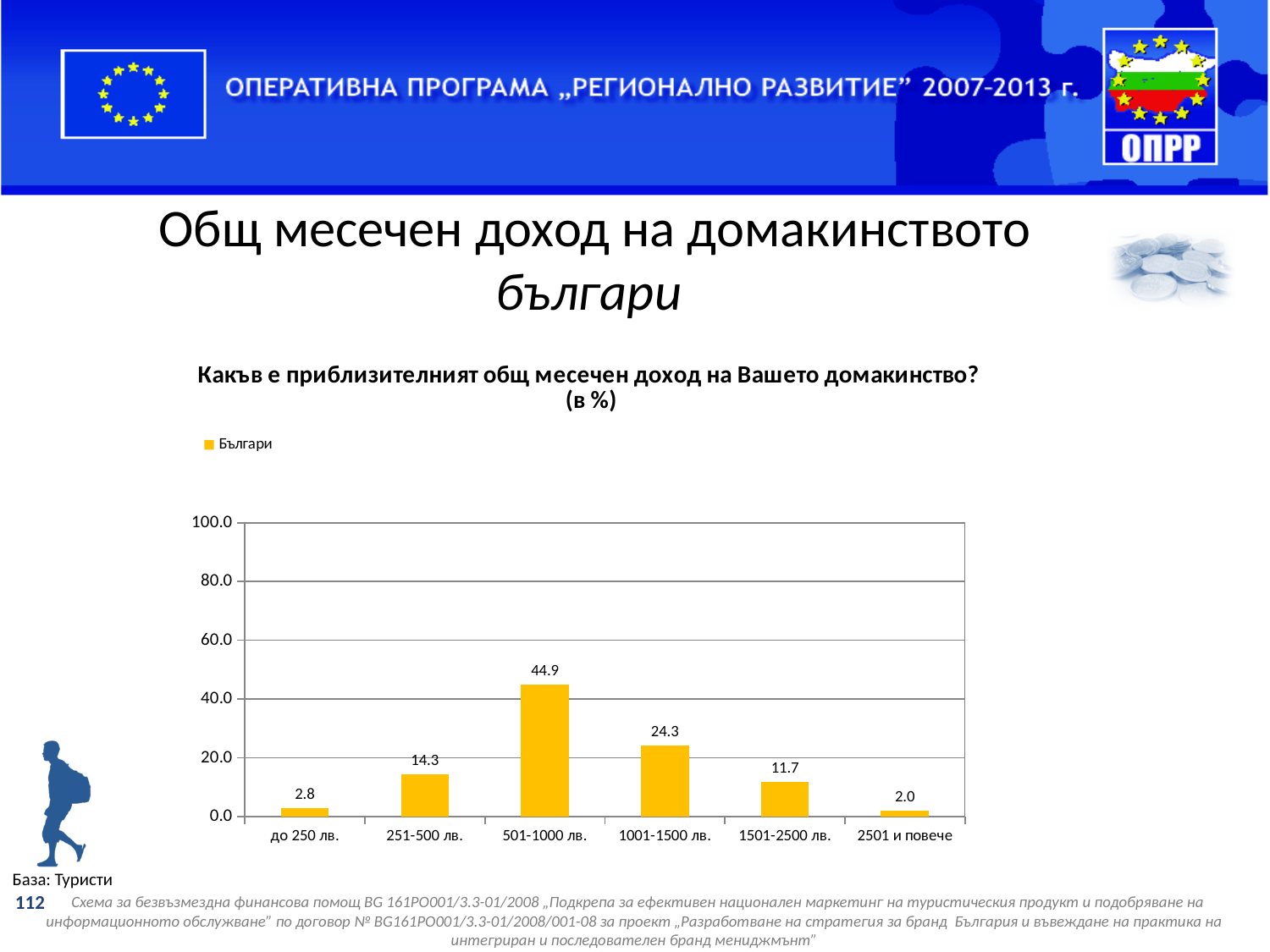
Which category has the highest value? 501-1000 лв. Which category has the lowest value? 2501 и повече What is the value for the category "501-1000 лв."? 44.9 What is the value for the category "1501-2500 лв."? 11.7 What is the difference between the values for "501-1000 лв." and "1001-1500 лв."? 20.6 Is the value for "1001-1500 лв." greater or less than 20.0? greater Which is larger, the value for "251-500 лв." or the value for "1501-2500 лв."? 251-500 лв. How many series does the legend list? 1 What is the name of the series listed in the legend? Българи How many categories are shown on the x axis? 6 What kind of chart is shown on the slide? bar chart What is the value for the category "до 250 лв."? 2.8